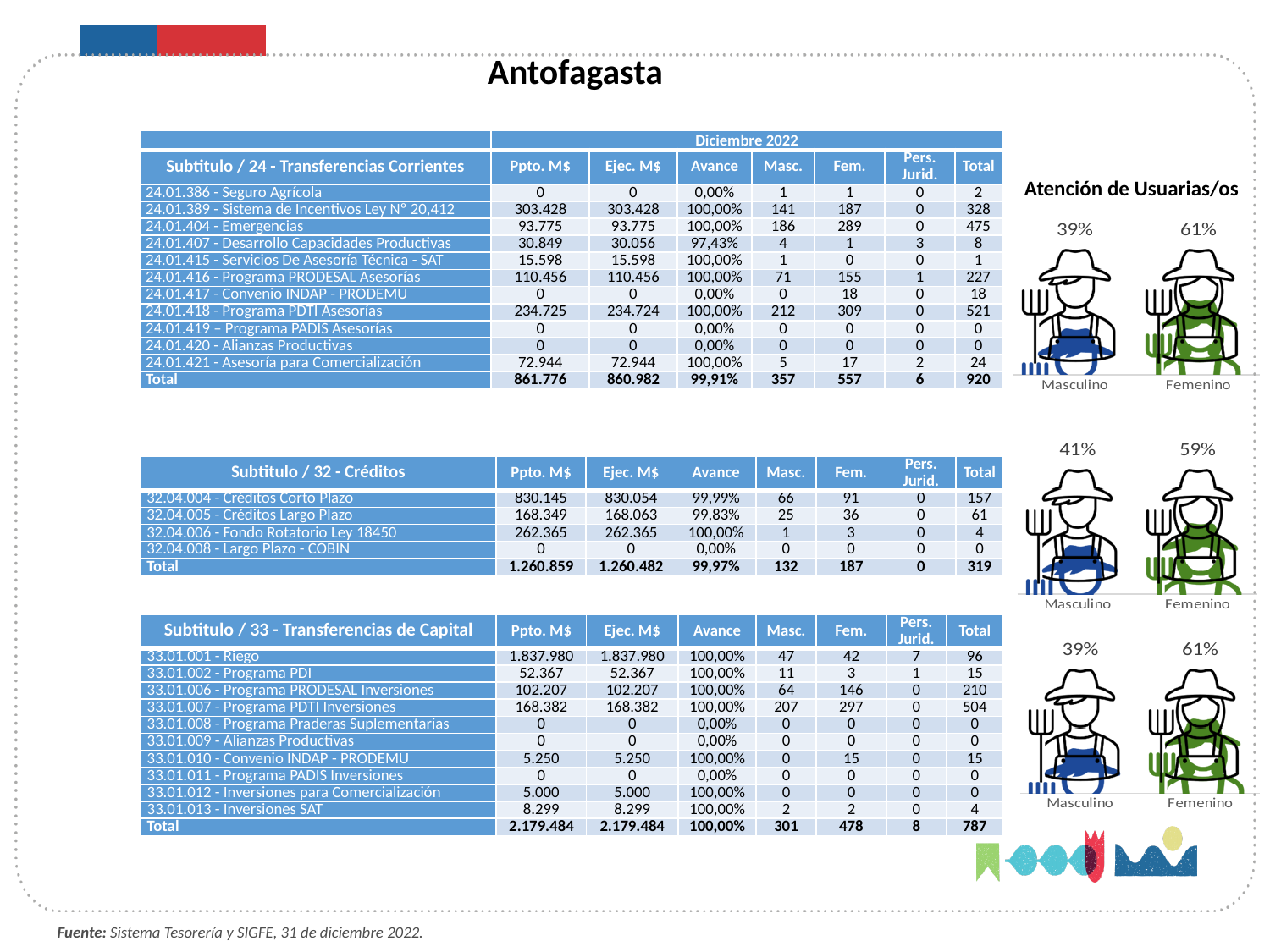
In the middle pictogram chart (next to the Subtítulo 32 - Créditos table), what percentage is shown for Masculino? 41% In the top 'Atención de Usuarias/os' pictogram chart, what is the difference in percentage points between Femenino and Masculino? 22 In the pictogram charts, which colour is used for the Femenino figure? Green In the top 'Atención de Usuarias/os' pictogram chart, what percentage is shown for Femenino? 61% In the bottom pictogram chart (next to the Subtítulo 33 - Transferencias de Capital table), what percentage is shown for Femenino? 61% In the top 'Atención de Usuarias/os' pictogram chart, what percentage is shown for Masculino? 39% In the middle pictogram chart, what is the difference in percentage points between Femenino and Masculino? 18 What is the title above the top pictogram chart on the right side of the slide? Atención de Usuarias/os In the middle pictogram chart, which category has the higher percentage, Masculino or Femenino? Femenino In the middle pictogram chart (next to the Subtítulo 32 - Créditos table), what percentage is shown for Femenino? 59% How many categories does each pictogram chart on the right side of the slide show? 2 In the bottom pictogram chart, which category has the lowest percentage? Masculino